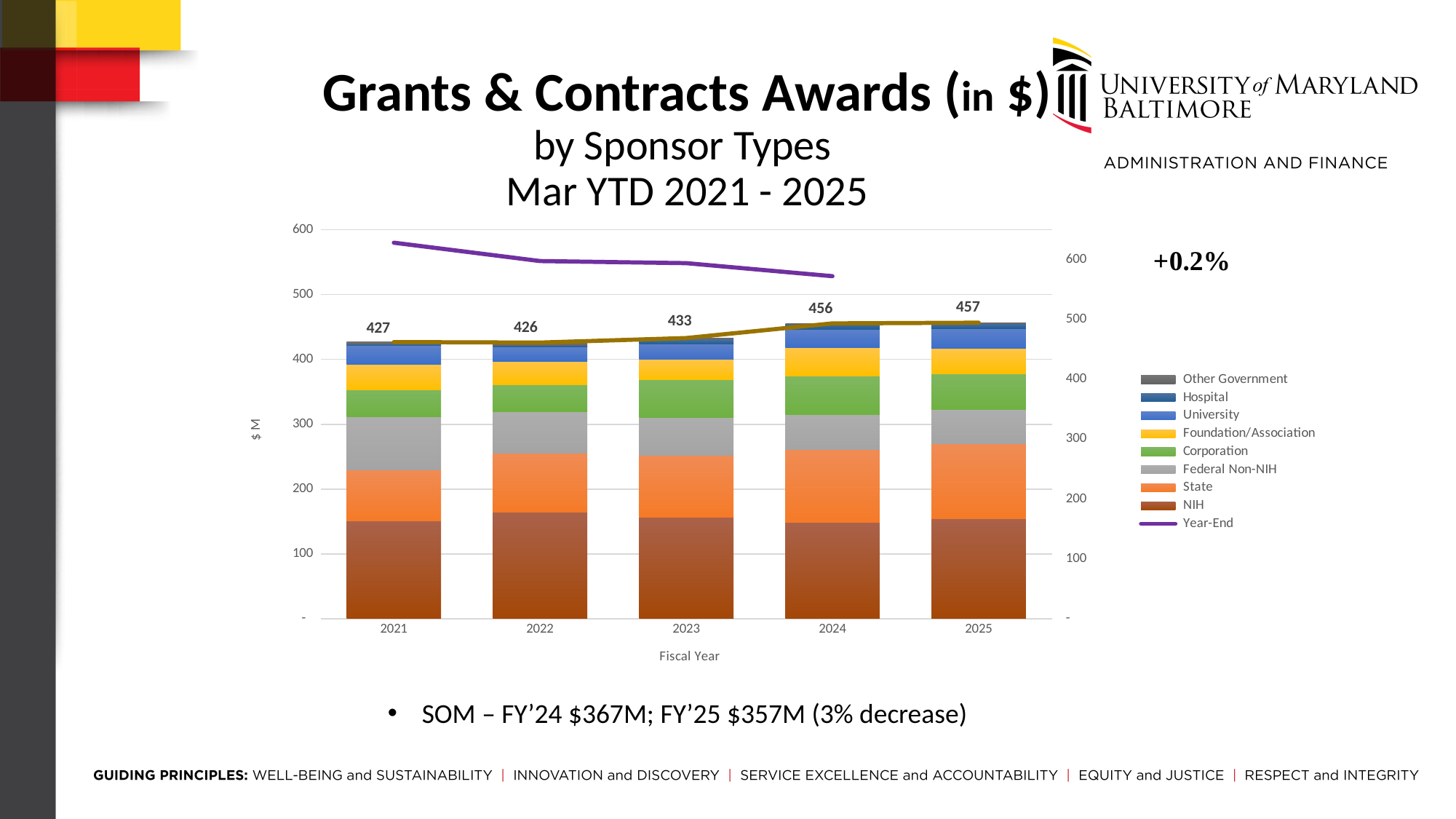
Is the Year-End line value for 2021 greater or less than 500? greater How many entries does the legend list? 9 What kind of chart is used to show the awards by sponsor type? Stacked bar chart with a line Which fiscal year has the lowest labeled total? 2022 Which labeled total is larger, 2023 or 2024? 2024 How many fiscal years are shown on the x axis? 5 Which fiscal year has the highest labeled total? 2025 What is the difference between the labeled totals for 2024 and 2021? 29 What is the total value labeled above the 2023 bar? 433 What is the total value labeled above the 2021 bar? 427 What is the total Grants & Contracts Awards value labeled for fiscal year 2025? 457 Does the Year-End line rise or fall from 2021 to 2024? Fall